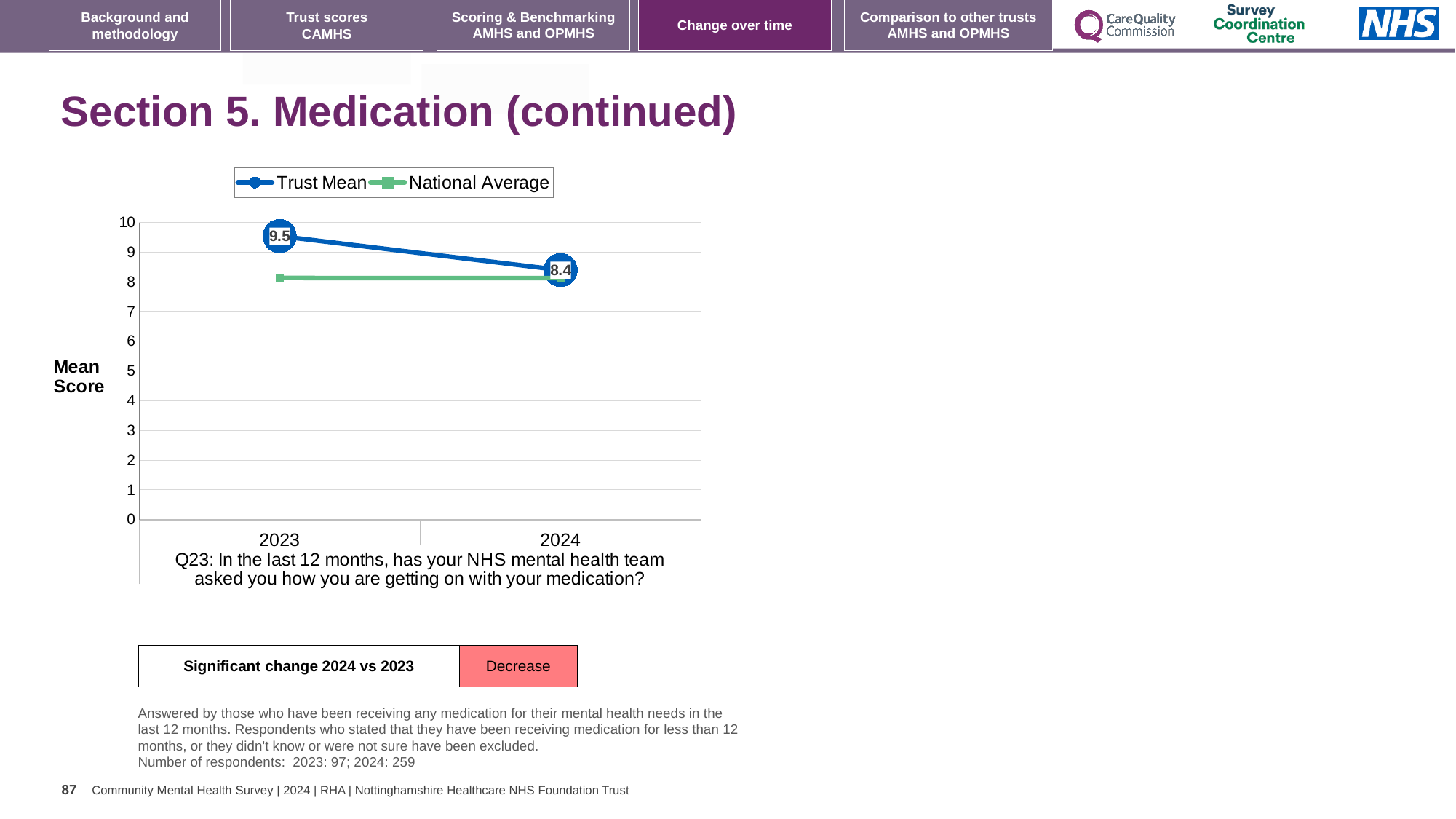
What is the label on the y axis of the chart? Mean Score How many series does the legend list? 2 Is the National Average value for 2023 greater or less than 9? less Which year has the higher Trust Mean, 2023 or 2024? 2023 What kind of chart is shown on the slide? line chart How many years are plotted on the x axis? 2 What is the Trust Mean value for 2024? 8.4 In 2023, which is higher, the Trust Mean or the National Average? Trust Mean Does the Trust Mean rise or fall from 2023 to 2024? fall By how much did the Trust Mean change from 2023 to 2024? 1.1 Is the National Average value for 2024 greater or less than 7? greater What is the Trust Mean value for 2023? 9.5